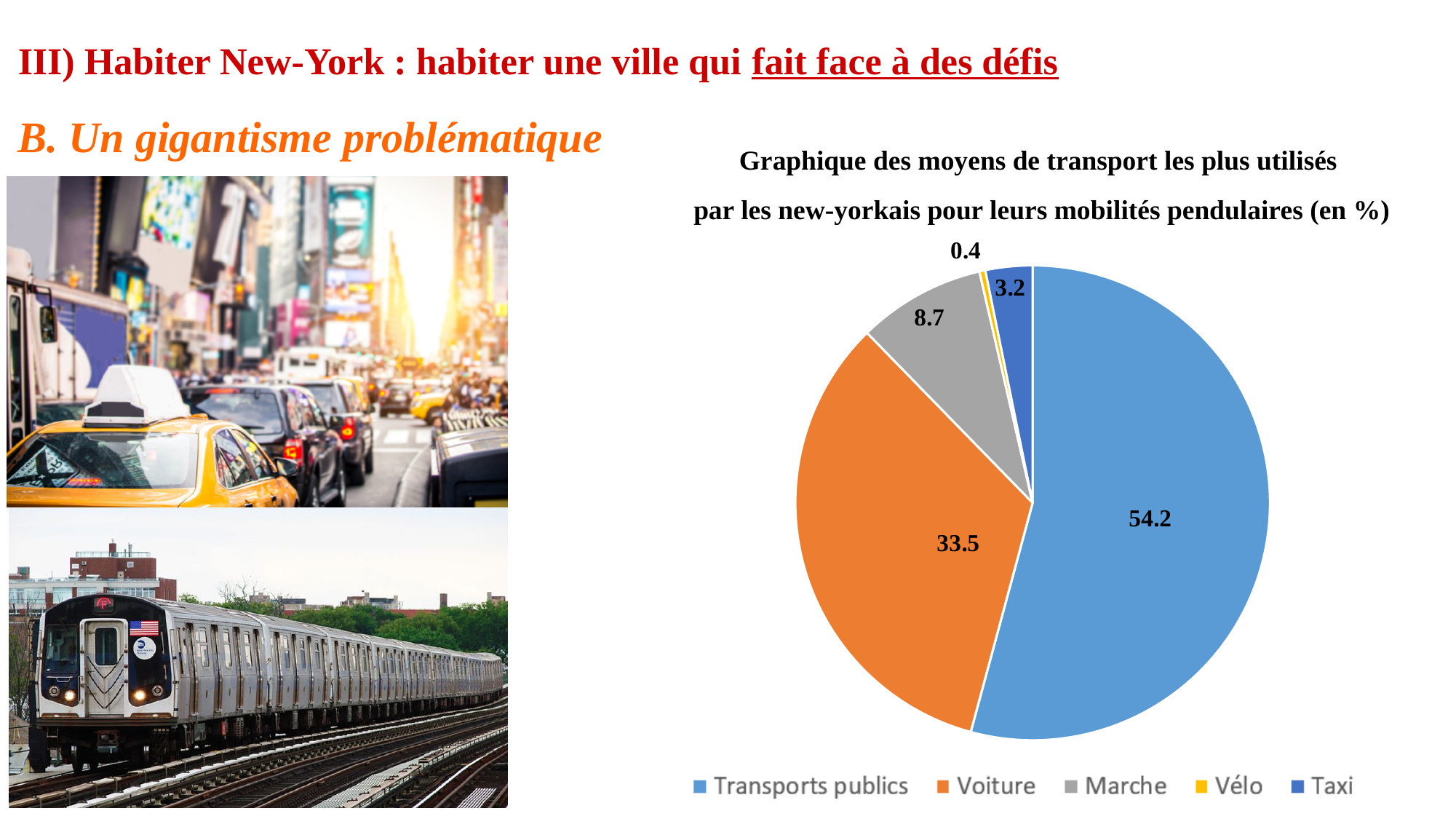
What is the value for Vélo? 0.4 Which category has the largest share of the pie? Transports publics How many categories does the pie chart show? 5 What is the difference between the values for Transports publics and Voiture? 20.7 Which colour represents Voiture in the pie chart? orange Which category has the smallest share of the pie? Vélo What is the value for Voiture? 33.5 What is the value for Marche? 8.7 Which is larger, the value for Marche or the value for Taxi? Marche What kind of chart is shown on the slide? pie chart What is the value for Taxi? 3.2 What is the value for Transports publics? 54.2